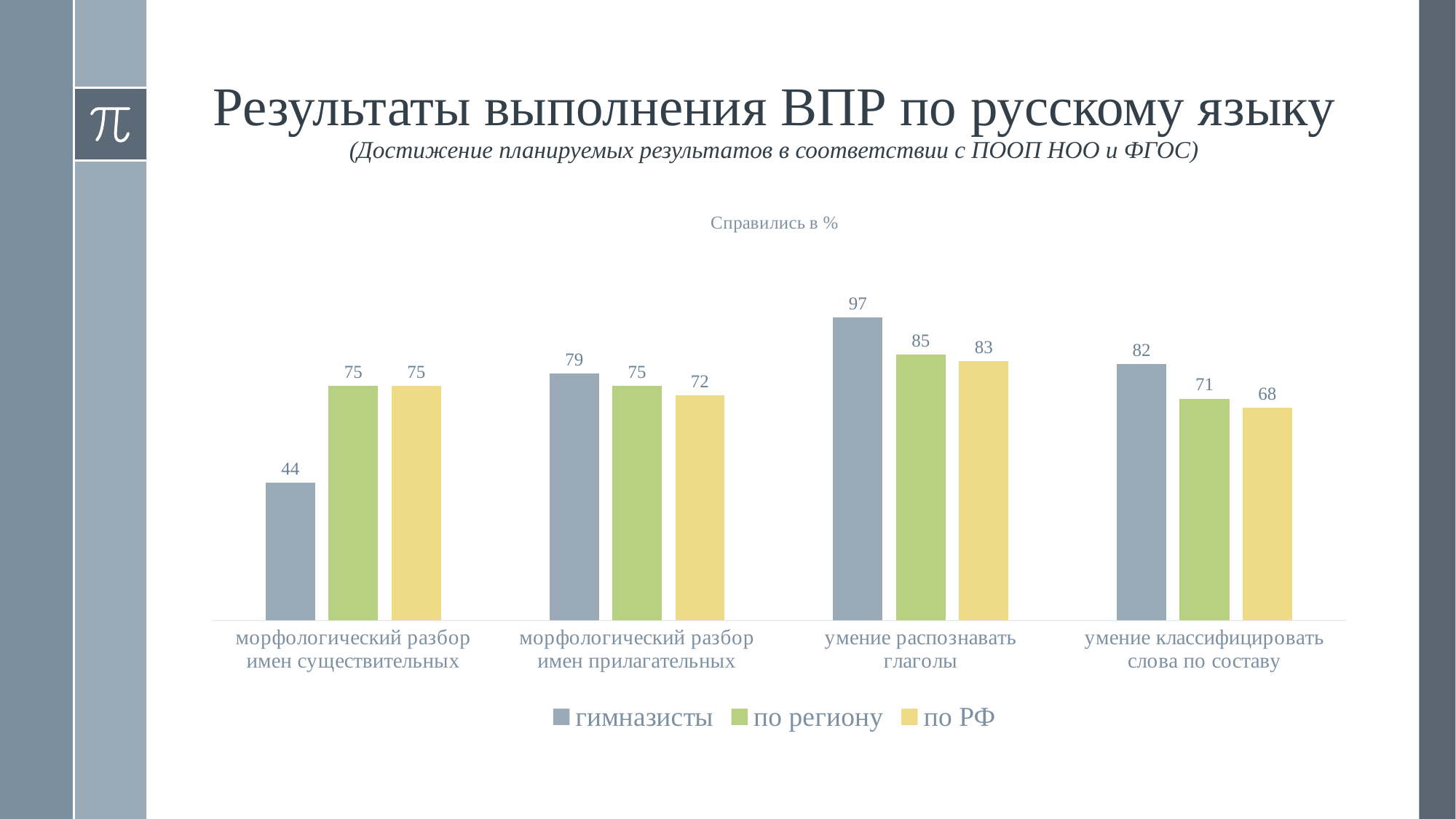
How many categories are shown on the x axis? 4 What is the value for гимназисты in the category морфологический разбор имен существительных? 44 What is the difference between гимназисты and по региону in the category умение классифицировать слова по составу? 11 What is the value for по РФ in the category умение классифицировать слова по составу? 68 What is the value for по региону in the category умение распознавать глаголы? 85 How many series does the legend list? 3 What is the title of the chart? Справились в % Which category has the highest value for гимназисты? умение распознавать глаголы Which series is shown in yellow? по РФ In the category морфологический разбор имен прилагательных, which is larger: гимназисты or по РФ? гимназисты Which category has the lowest value for по РФ? умение классифицировать слова по составу What kind of chart is shown on the slide? bar chart